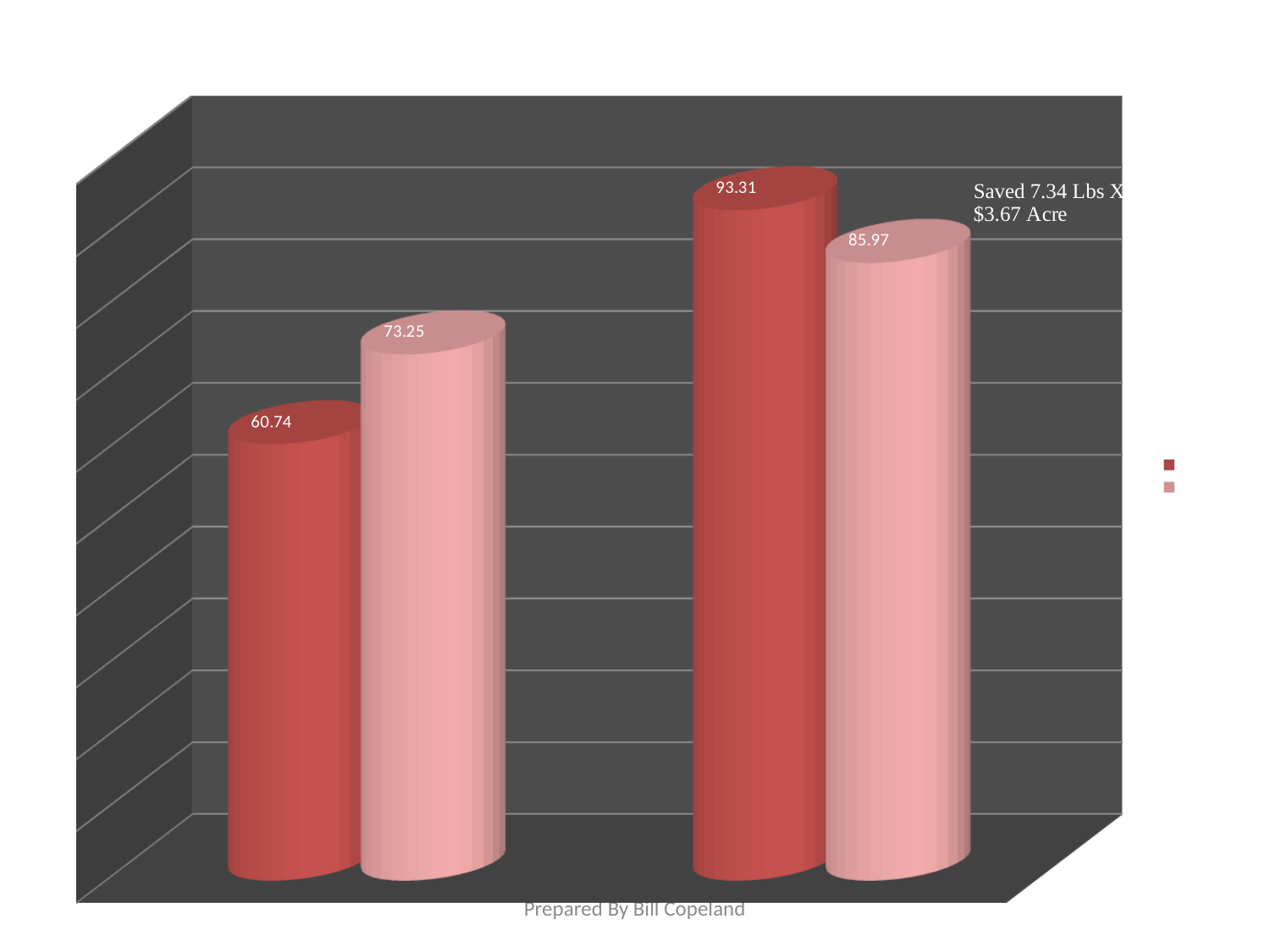
What is the lowest value shown on the chart? 60.74 How many series does the legend list? 2 What is the value of the light pink bar in the right group? 85.97 What is the value of the light pink bar in the left group? 73.25 What is the difference between the light pink bar and the dark red bar in the left group? 12.51 What is the difference between the dark red bar and the light pink bar in the right group? 7.34 What is the highest value shown on the chart? 93.31 What kind of chart is shown on the slide? bar chart How many bars are plotted on the chart? 4 What is the value of the dark red bar in the right group? 93.31 In the left group, which bar is larger, the dark red one or the light pink one? the light pink one What is the value of the dark red bar in the left group? 60.74